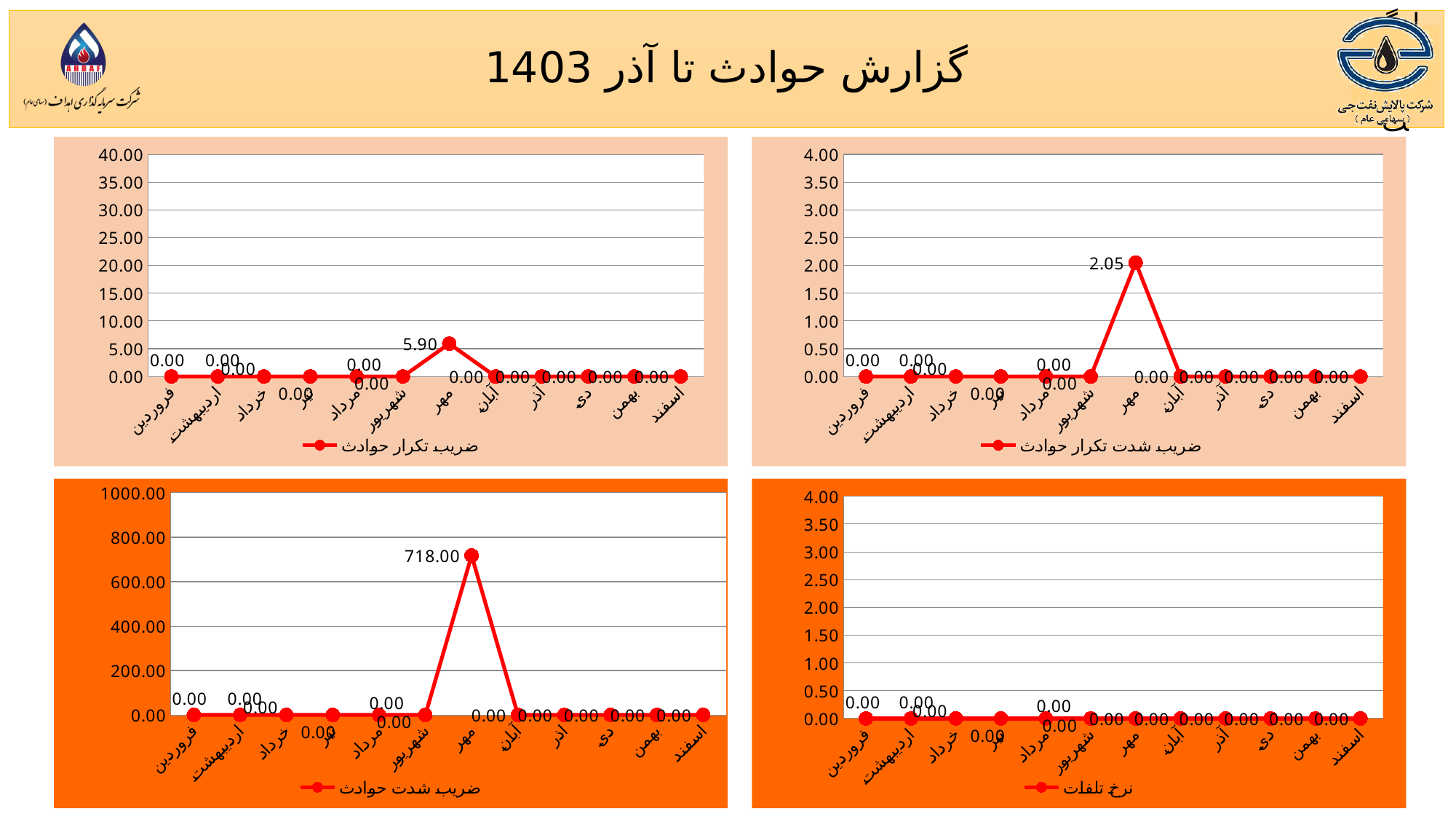
In the bottom-right chart, what is the value for مهر (Mehr)? 0.00 In the top-left chart, which month has the highest value? مهر What is the legend entry of the bottom-right chart? نرخ تلفات In the top-left chart, what is the value for مهر (Mehr)? 5.90 How many months are plotted on the x axis of the top-left chart? 12 In the bottom-left chart, which month has the highest value? مهر In the top-right chart, is the value for مهر greater or less than 1.50? greater How many series does the legend of the bottom-right chart list? 1 What kind of chart is the bottom-left chart? line chart In the bottom-left chart, what is the value for مهر (Mehr)? 718.00 In the top-right chart, what is the value for مهر (Mehr)? 2.05 In the bottom-left chart, what is the difference between the value for مهر and the value for آبان? 718.00